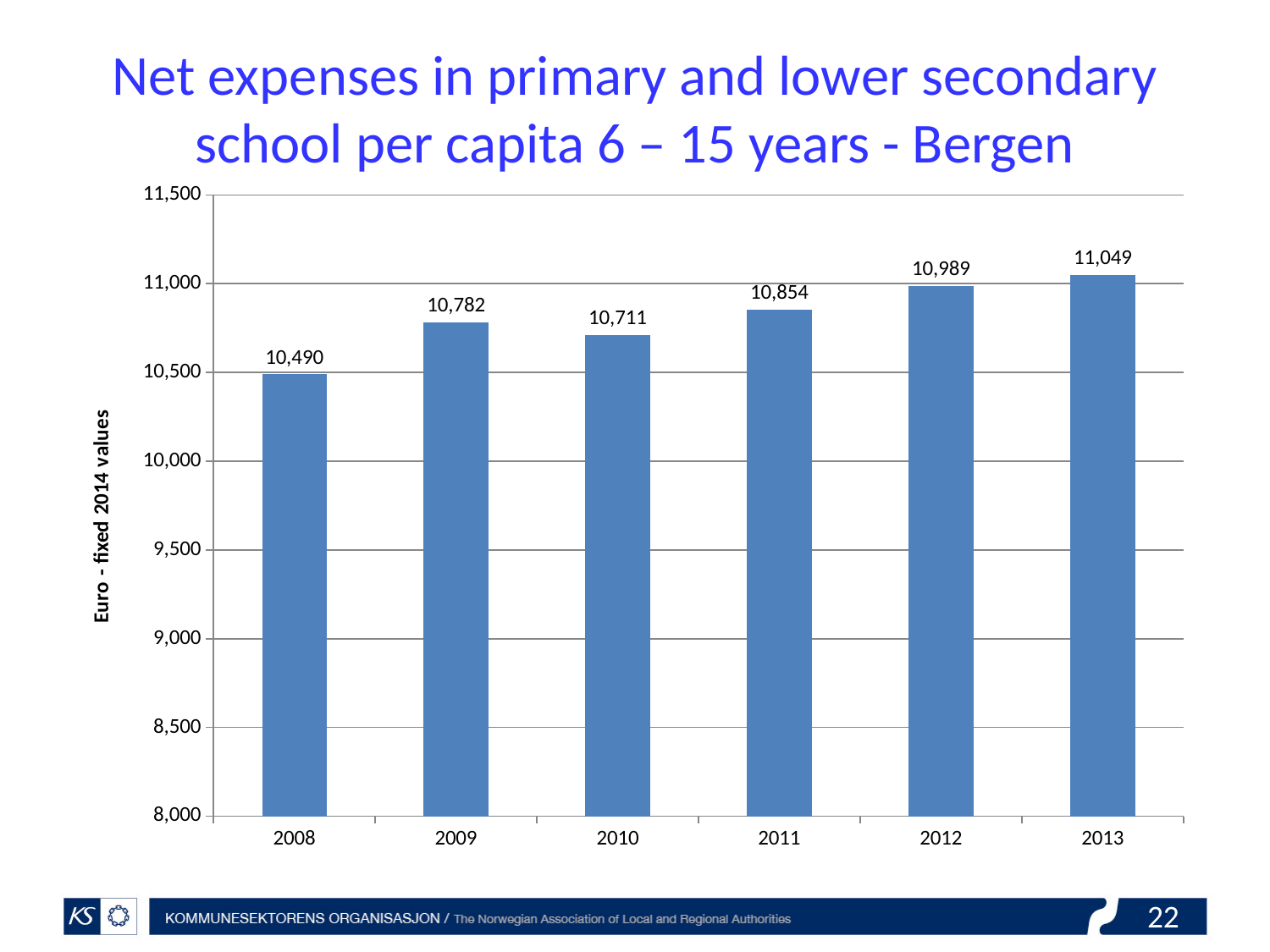
Which is larger, the value for 2009 or the value for 2010? 2009 What is the difference between the values for 2013 and 2008? 559 How many years are shown on the x axis? 6 What is the value for 2011? 10,854 Which year has the highest value? 2013 What is the label of the vertical axis? Euro - fixed 2014 values What is the difference between the values for 2009 and 2010? 71 What is the value for 2008? 10,490 What is the value for 2013? 11,049 Which year has the lowest value? 2008 What kind of chart is shown on the slide? bar chart Is the value for 2012 greater or less than 11,000? less